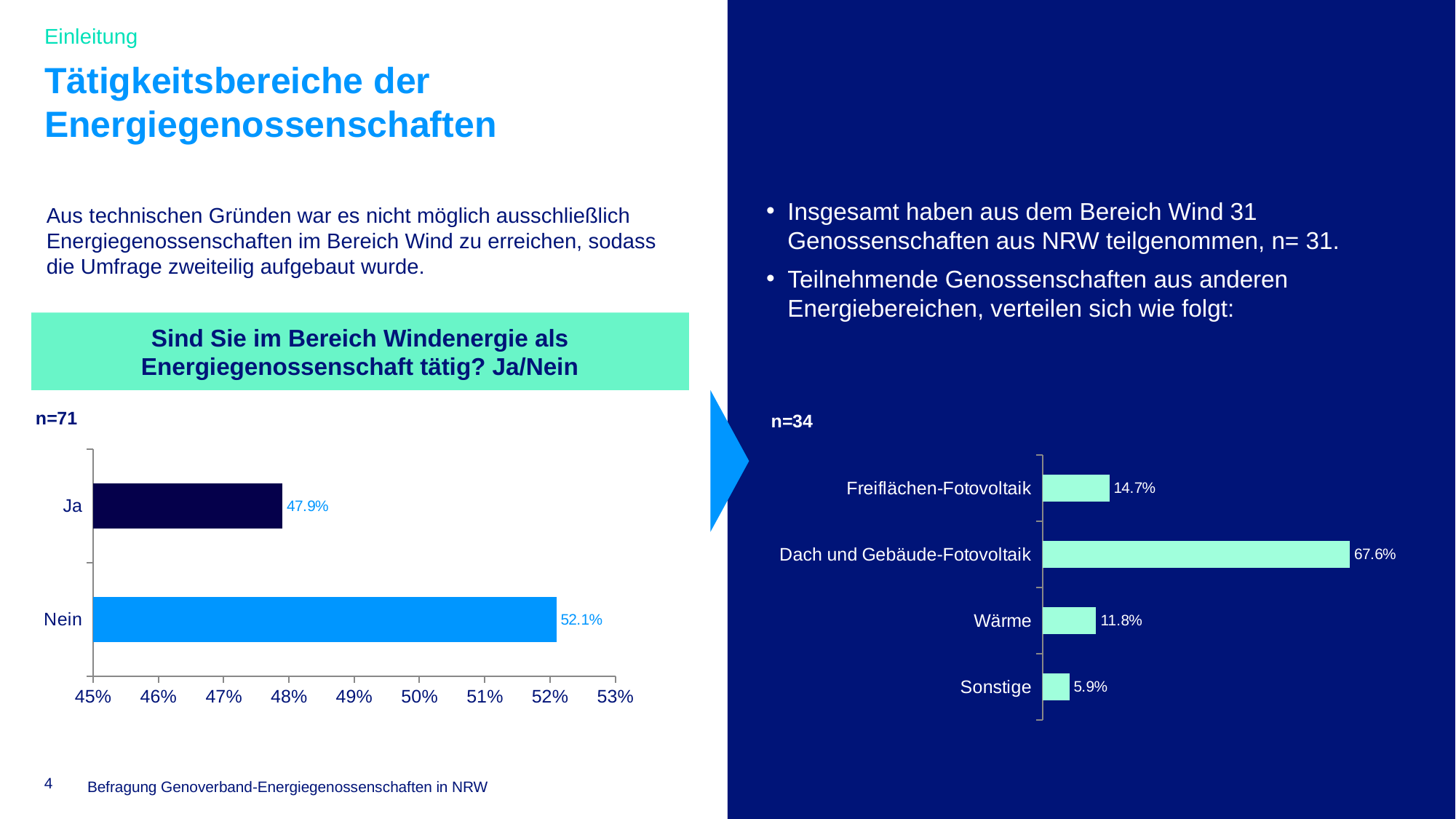
In the left chart (Ja/Nein), what is the value for Ja? 47.9% In the right chart (n=34), how many categories are shown? 4 In the left chart (Ja/Nein), which category has the higher value, Ja or Nein? Nein What kind of chart is the left chart (Ja/Nein)? bar chart In the left chart (Ja/Nein), what is the difference between the Nein and Ja values? 4.2% In the right chart (n=34), what is the difference between Freiflächen-Fotovoltaik and Sonstige? 8.8% In the right chart (n=34), which category has the highest value? Dach und Gebäude-Fotovoltaik In the left chart (Ja/Nein), what is the value for Nein? 52.1% In the left chart (Ja/Nein), is the value for Ja greater or less than 50%? less In the right chart (n=34), which category has the lowest value? Sonstige In the right chart (n=34), what is the value for Dach und Gebäude-Fotovoltaik? 67.6% In the right chart (n=34), what is the value for Wärme? 11.8%